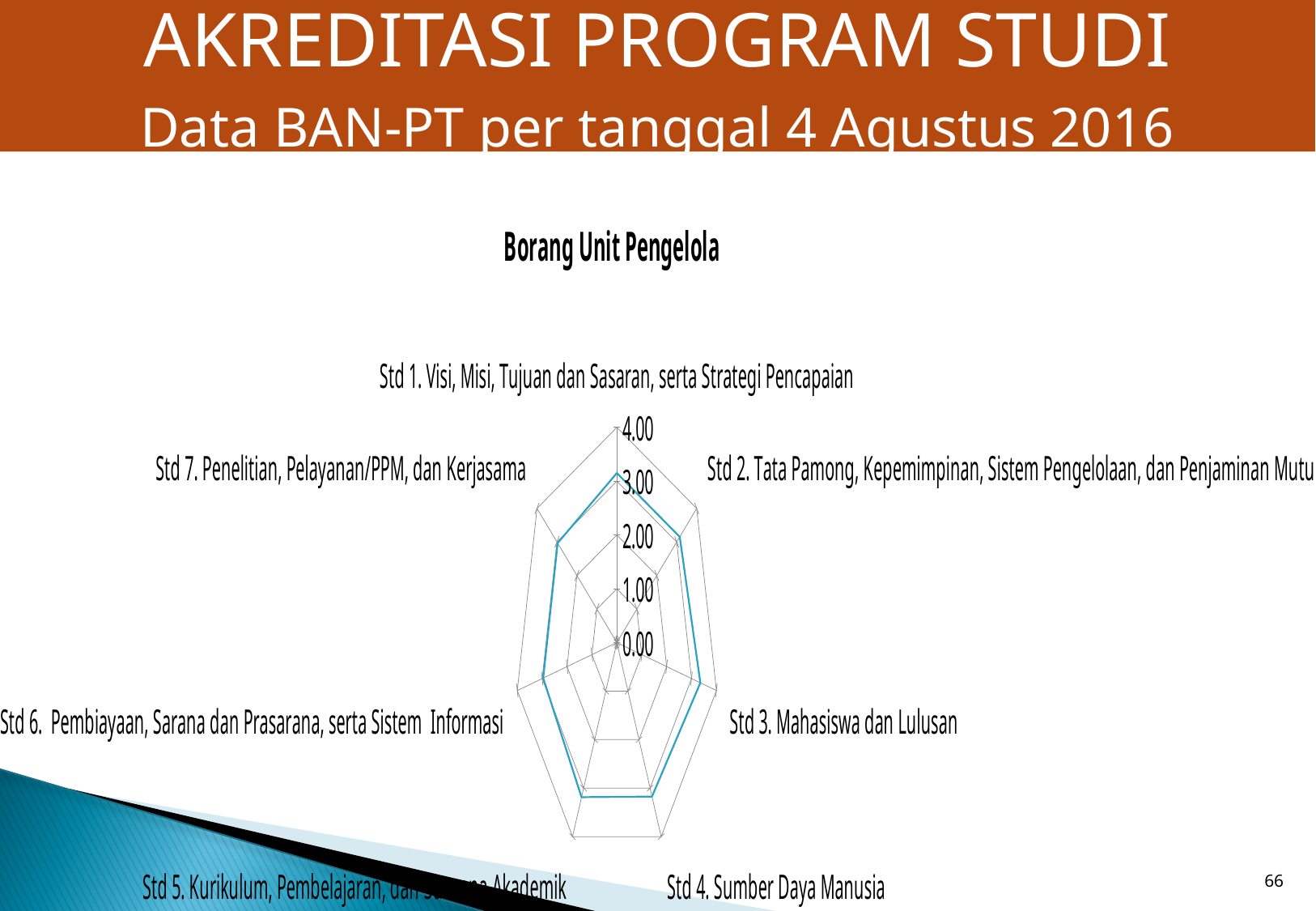
Is the value for Std 5. Kurikulum, Pembelajaran, dan Suasana Akademik greater or less than 2.00? greater What kind of chart is shown on the slide? Radar chart What is the highest value shown on the chart's axis scale? 4.00 Is the value for Std 3. Mahasiswa dan Lulusan greater or less than 4.00? less Which is larger, the value for Std 1. Visi, Misi, Tujuan dan Sasaran, serta Strategi Pencapaian or the value for Std 3. Mahasiswa dan Lulusan? Std 3. Mahasiswa dan Lulusan Is the value for Std 4. Sumber Daya Manusia greater or less than 3.00? greater How many standards (categories) are plotted on the radar chart? 7 What is the title of the chart? Borang Unit Pengelola